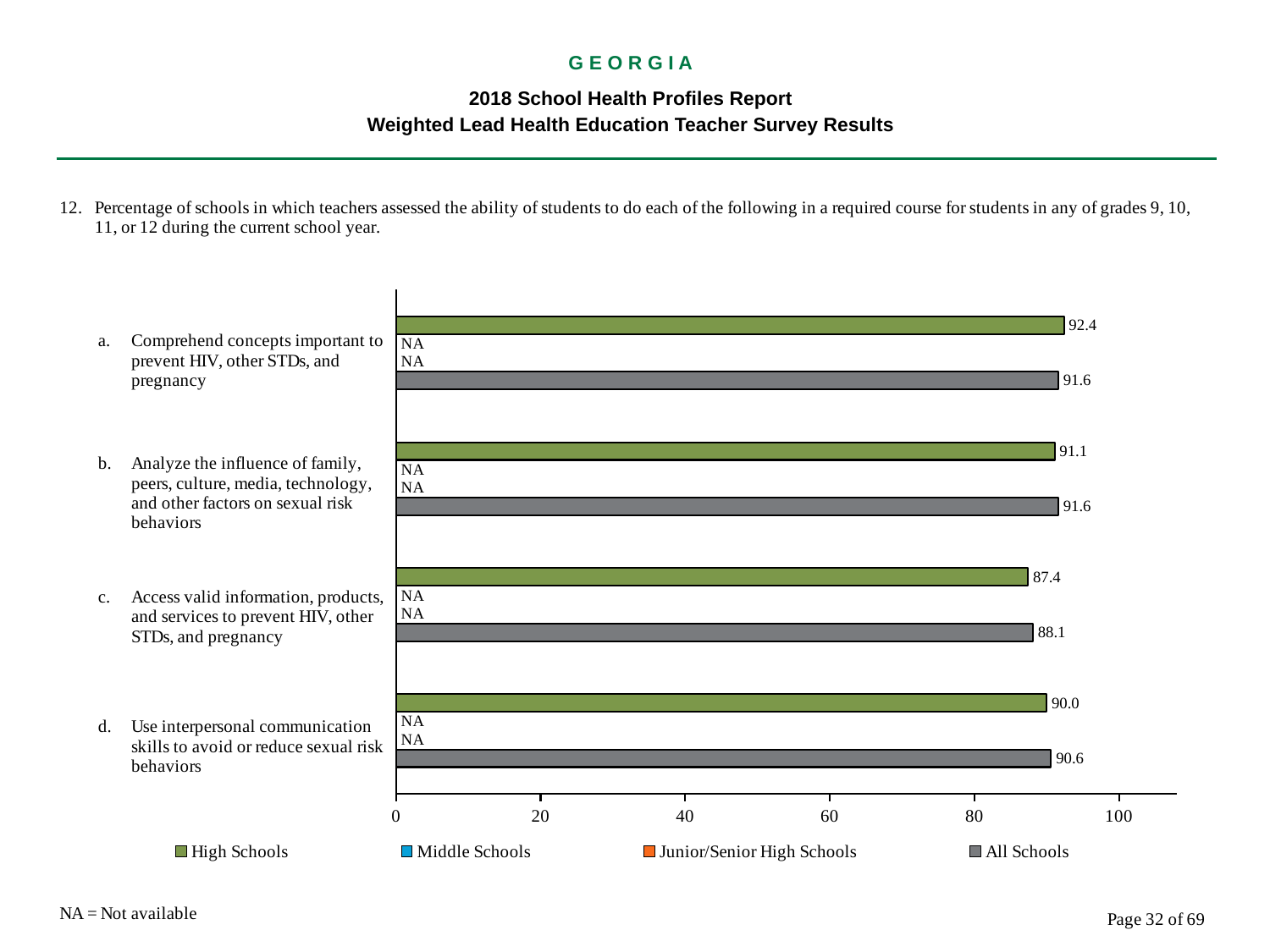
What kind of chart is shown on the slide? Bar chart Which category has the highest High Schools value? Comprehend concepts important to prevent HIV, other STDs, and pregnancy What is the All Schools value for "Analyze the influence of family, peers, culture, media, technology, and other factors on sexual risk behaviors"? 91.6 What value is shown for Middle Schools in every category? NA What is the High Schools value for "Use interpersonal communication skills to avoid or reduce sexual risk behaviors"? 90.0 How many series does the legend list? 4 What is the All Schools value for "Access valid information, products, and services to prevent HIV, other STDs, and pregnancy"? 88.1 What is the difference between the High Schools and All Schools values for "Comprehend concepts important to prevent HIV, other STDs, and pregnancy"? 0.8 What is the High Schools value for "Comprehend concepts important to prevent HIV, other STDs, and pregnancy"? 92.4 How many categories are shown on the chart? 4 For "Use interpersonal communication skills to avoid or reduce sexual risk behaviors", which is larger: the High Schools value or the All Schools value? All Schools Which category has the lowest All Schools value? Access valid information, products, and services to prevent HIV, other STDs, and pregnancy